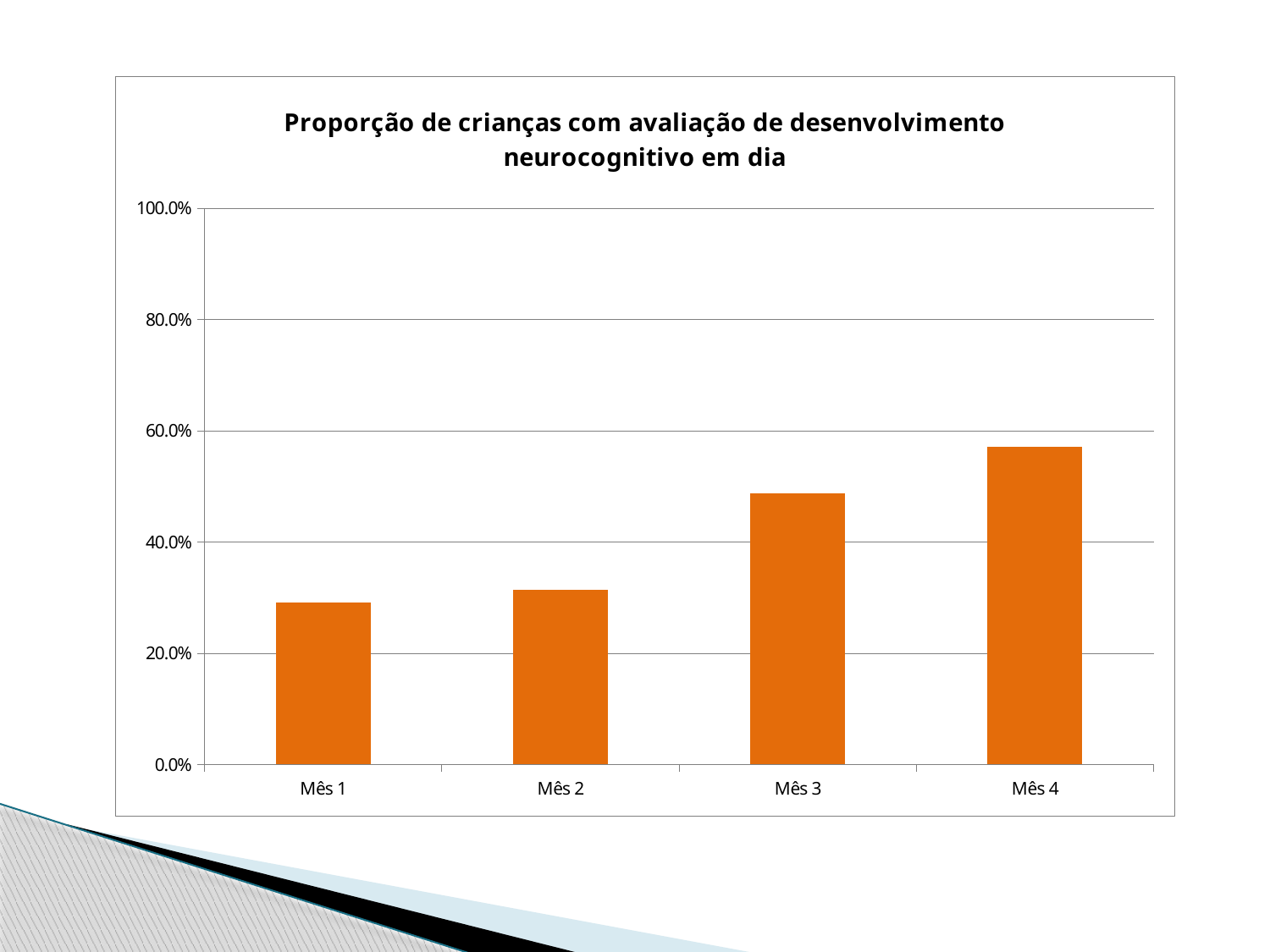
Which month has the highest proportion? Mês 4 What kind of chart is shown on the slide? bar chart Which is larger, the value for Mês 3 or the value for Mês 4? Mês 4 Which month has the lowest proportion? Mês 1 Is the value for Mês 4 greater or less than 40.0%? greater How many categories (months) are plotted on the x axis? 4 What is the title of the chart? Proporção de crianças com avaliação de desenvolvimento neurocognitivo em dia Is the value for Mês 1 greater or less than 40.0%? less Is the value for Mês 2 greater or less than 20.0%? greater Do the values rise or fall from Mês 1 to Mês 4? rise Which is larger, the value for Mês 2 or the value for Mês 3? Mês 3